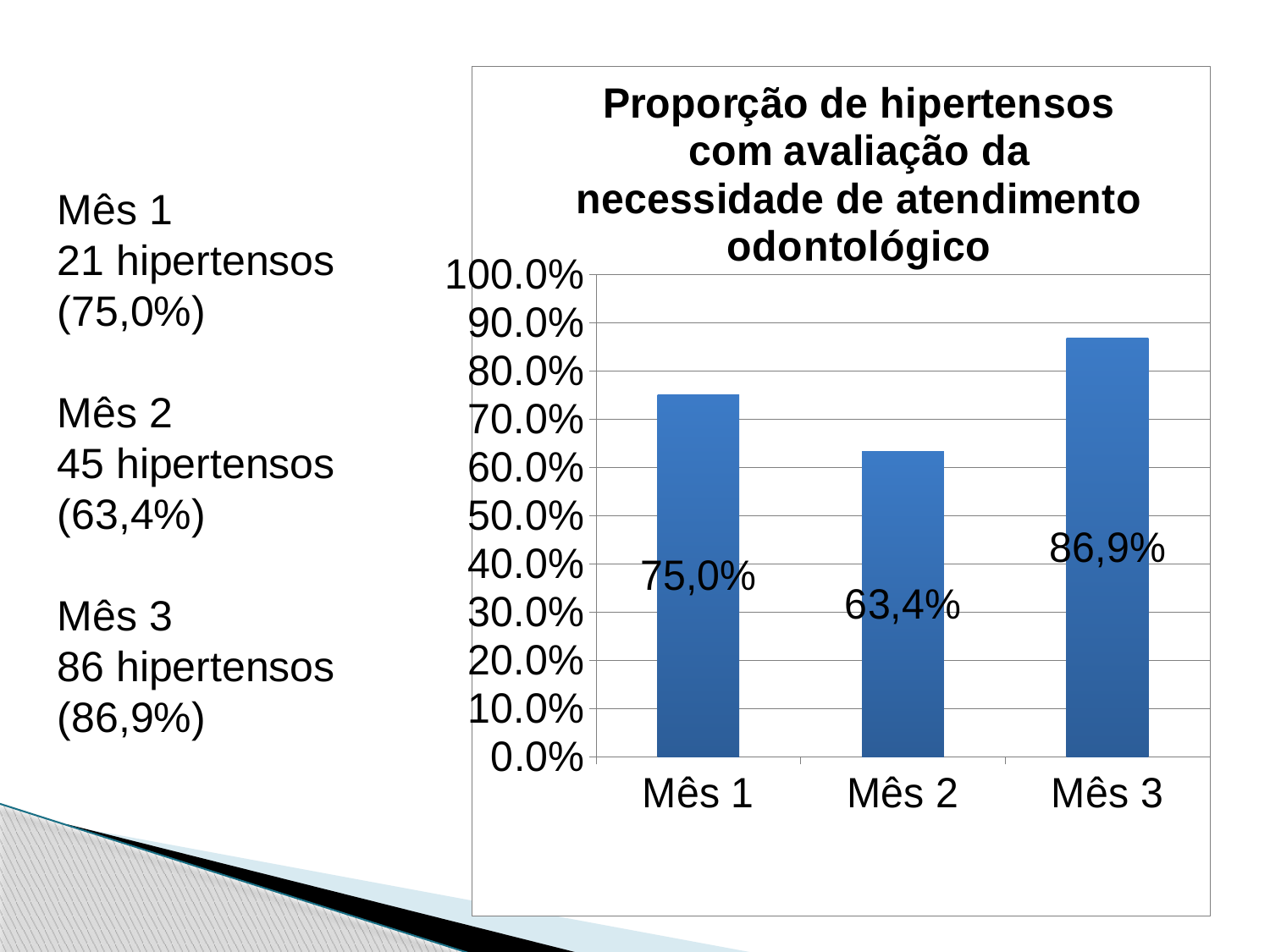
What is the value for Mês 2? 63,4% Which month has the lowest proportion? Mês 2 Which month has the highest proportion? Mês 3 What is the difference between the values for Mês 1 and Mês 2? 11,6% What is the value for Mês 3? 86,9% How many categories are shown on the x axis? 3 Is the value for Mês 2 greater or less than 70.0%? less What is the value for Mês 1? 75,0% What is the difference between the values for Mês 3 and Mês 1? 11,9% Which is larger, the value for Mês 1 or the value for Mês 2? Mês 1 What is the title of the chart? Proporção de hipertensos com avaliação da necessidade de atendimento odontológico What kind of chart is shown? bar chart